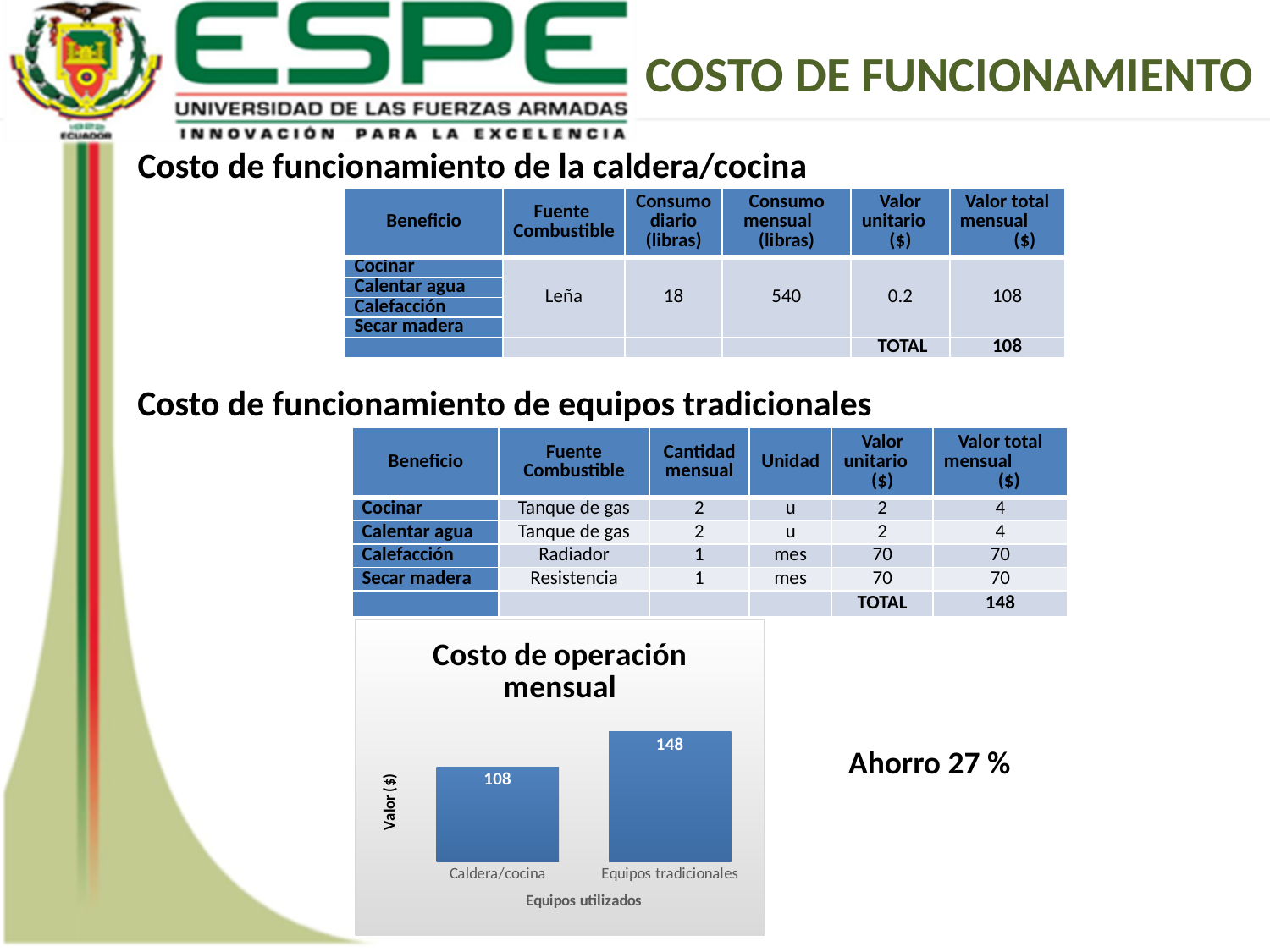
What is the value for Equipos tradicionales in the chart? 148 What is the difference between the values for Equipos tradicionales and Caldera/cocina? 40 Do the values rise or fall from Caldera/cocina to Equipos tradicionales? Rise What is the label of the x axis of the chart? Equipos utilizados Which is larger, the value for Caldera/cocina or for Equipos tradicionales? Equipos tradicionales Which category has the lowest value in the chart? Caldera/cocina What is the title of the chart? Costo de operación mensual What is the value for Caldera/cocina in the chart? 108 Which category has the highest value in the chart? Equipos tradicionales What kind of chart is shown on the slide? Bar chart How many categories are shown on the x axis of the chart? 2